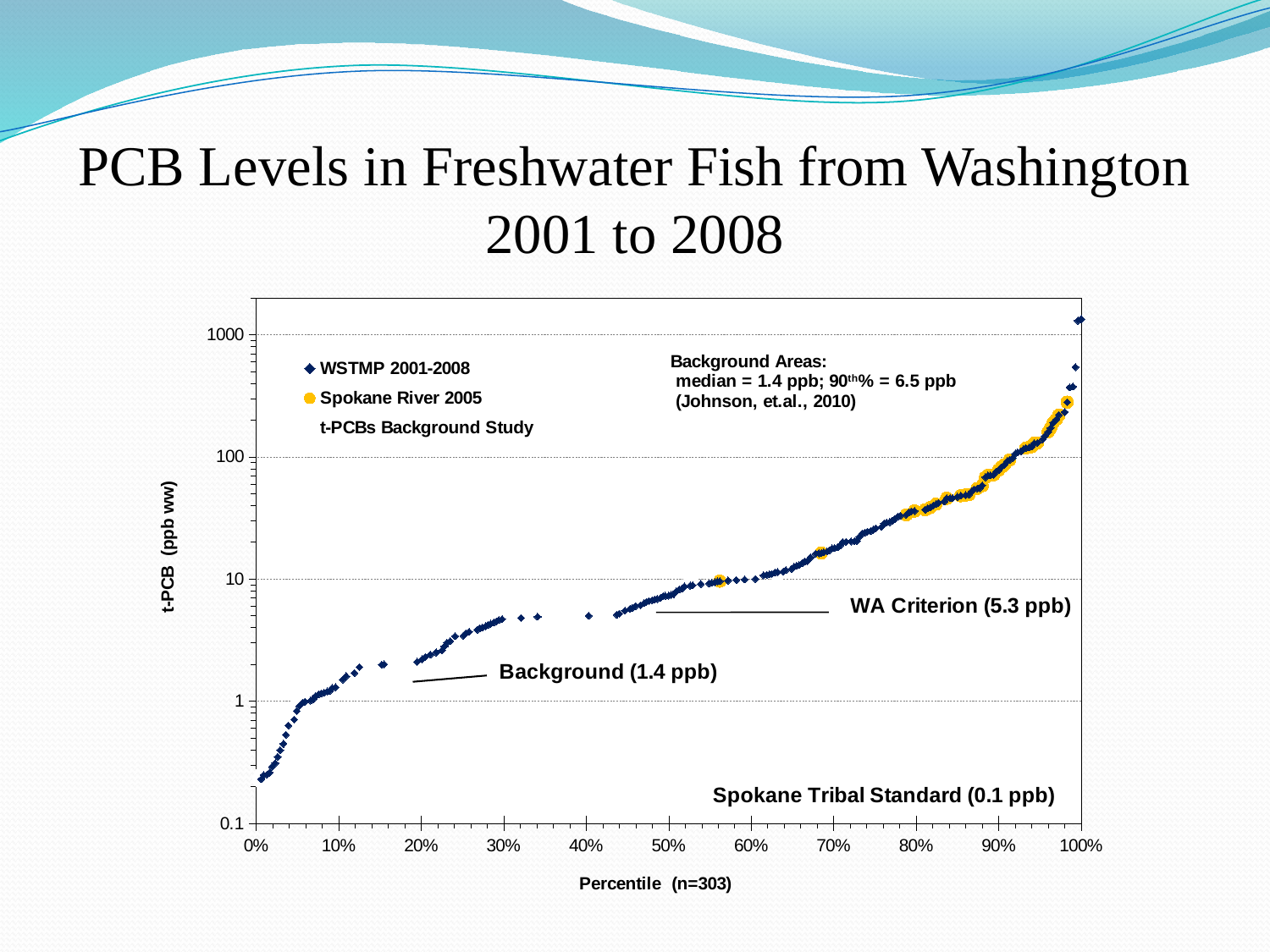
Is the highest plotted t-PCB value greater or less than 1000? greater What value is given for the WA Criterion annotation? 5.3 ppb Is the t-PCB value at the 90% percentile greater or less than 10? greater According to the text box, what is the 90th percentile t-PCB value for Background Areas? 6.5 ppb What kind of chart is shown on the slide? scatter chart Is the t-PCB value at the 50% percentile greater or less than 10? less What value is given for the Background annotation? 1.4 ppb How many samples (n) does the x-axis label indicate? 303 Do the t-PCB values rise or fall as the percentile increases along the x axis? rise What value is given for the Spokane Tribal Standard? 0.1 ppb Which series is plotted with yellow circle markers? Spokane River 2005 What is the title of the chart on the slide? PCB Levels in Freshwater Fish from Washington 2001 to 2008